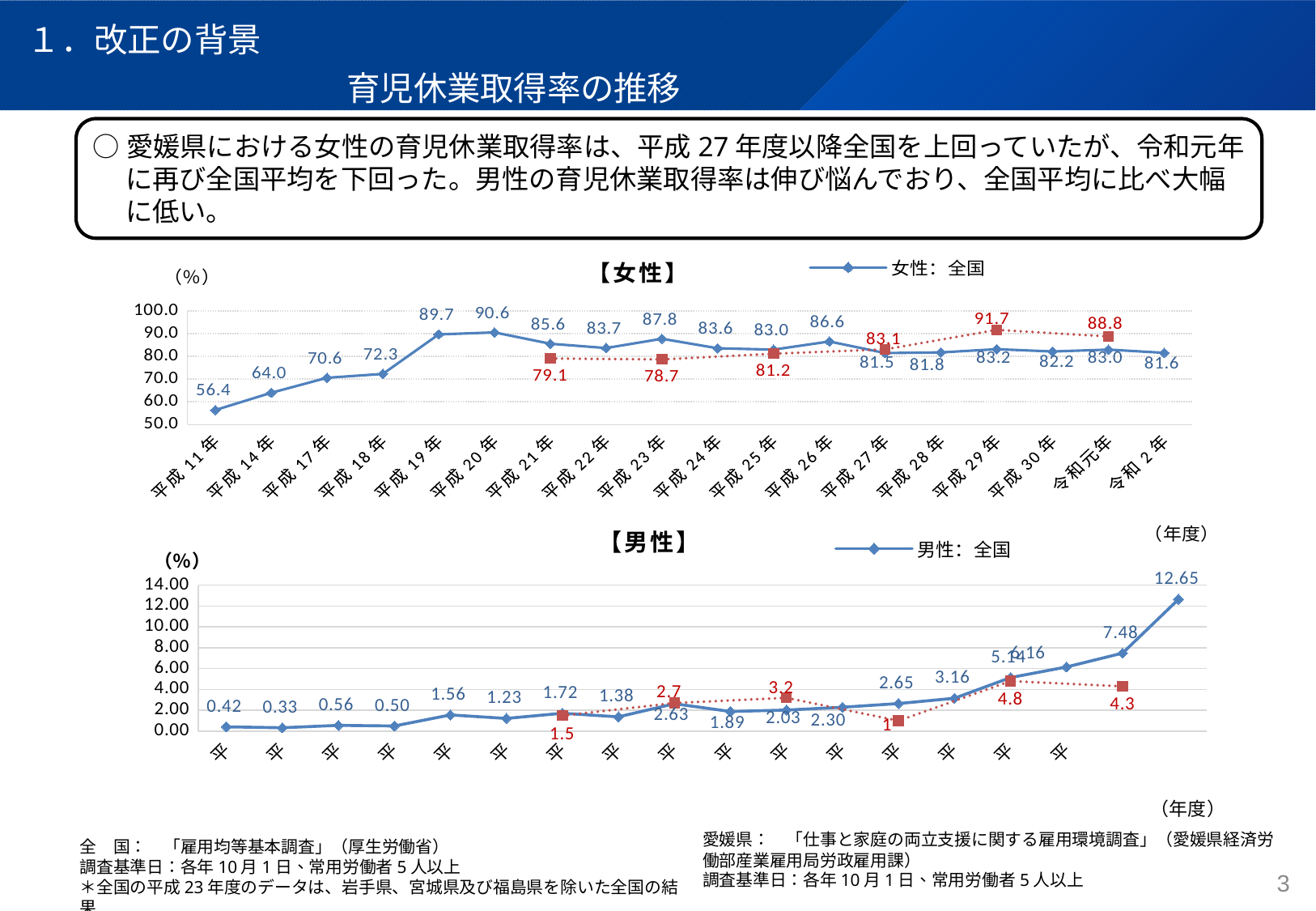
In the 【男性】 chart, what is the highest value of the 男性: 全国 series? 12.65 In the 【女性】 chart, what is the 女性: 全国 value for 平成11年? 56.4 In the 【女性】 chart, does the 女性: 全国 series rise or fall from 平成11年 to 平成20年? rise In the 【女性】 chart, what is the difference between the 女性: 全国 values for 平成19年 and 平成18年? 17.4 What kind of chart is the 【男性】 chart? line chart In the 【女性】 chart, in which year does the 女性: 全国 series reach its highest value? 平成20年 How many years are shown on the x axis of the 【女性】 chart? 18 How many series does the legend of the 【男性】 chart list? 1 In the 【女性】 chart, what is the value of the red dotted series at 令和元年? 88.8 In the 【女性】 chart, what is the 女性: 全国 value for 平成20年? 90.6 In the 【女性】 chart, at 平成29年, which is larger: the 女性: 全国 value or the red dotted series value? the red dotted series In the 【女性】 chart, in which year is the 女性: 全国 series lowest? 平成11年